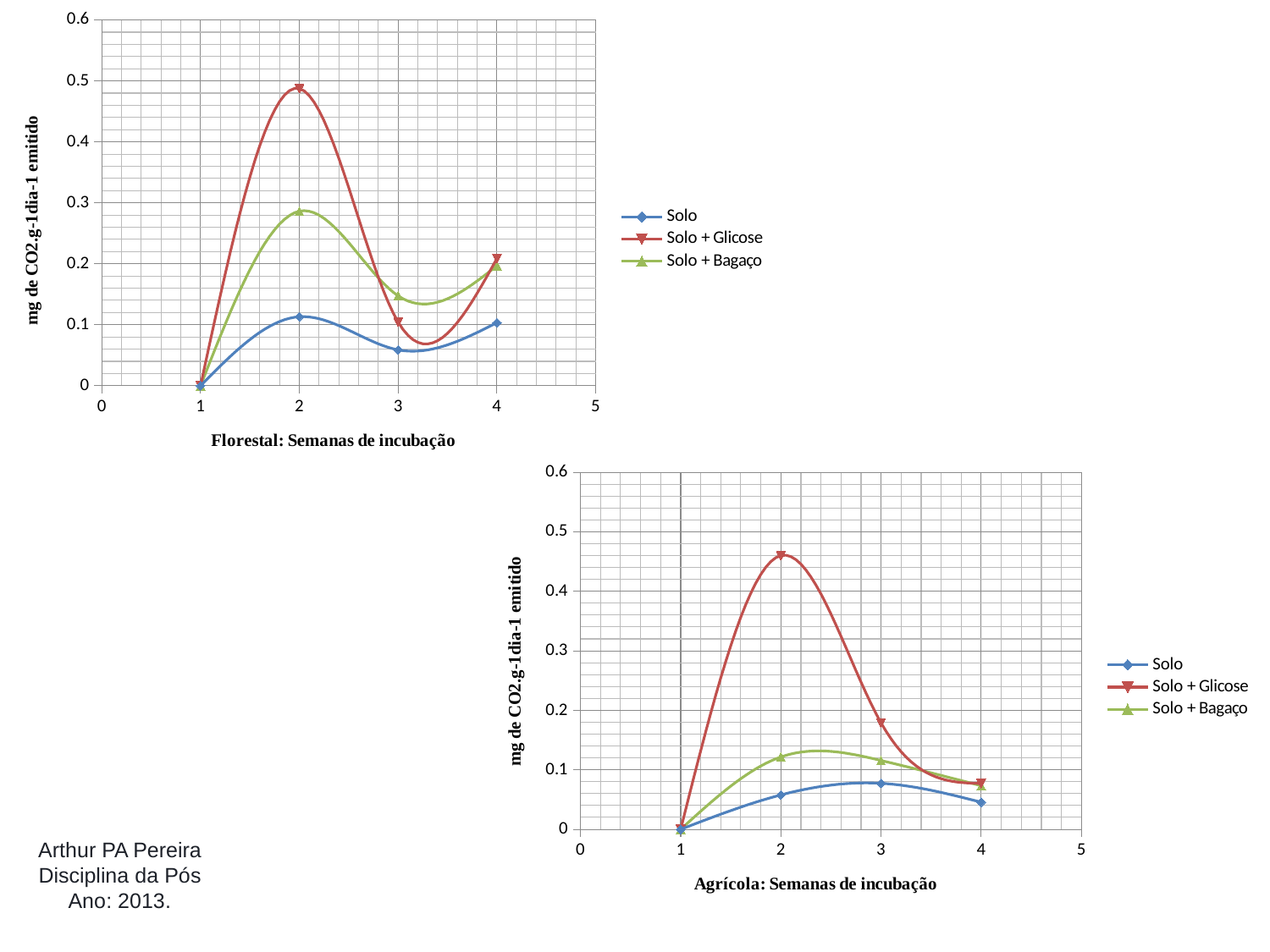
How many data points does each series have in the 'Agrícola: Semanas de incubação' chart? 4 In the 'Florestal: Semanas de incubação' chart, which series has the highest value at week 2? Solo + Glicose In the 'Agrícola: Semanas de incubação' chart, which series has the highest value at week 2? Solo + Glicose In the 'Agrícola: Semanas de incubação' chart, does the Solo + Glicose series rise or fall from week 2 to week 4? fall What is the y-axis title of the 'Agrícola: Semanas de incubação' chart? mg de CO2.g-1dia-1 emitido In the 'Agrícola: Semanas de incubação' chart, is the value for Solo + Bagaço at week 2 greater or less than 0.2? less In the 'Florestal: Semanas de incubação' chart, which series has the lowest value at week 3? Solo In the 'Florestal: Semanas de incubação' chart, is the value for Solo + Glicose at week 2 greater or less than 0.4? greater In the 'Florestal: Semanas de incubação' chart, is the value for Solo at week 2 greater or less than 0.2? less What kind of chart is the top chart, titled 'Florestal: Semanas de incubação'? line chart How many series does the legend of the 'Florestal: Semanas de incubação' chart list? 3